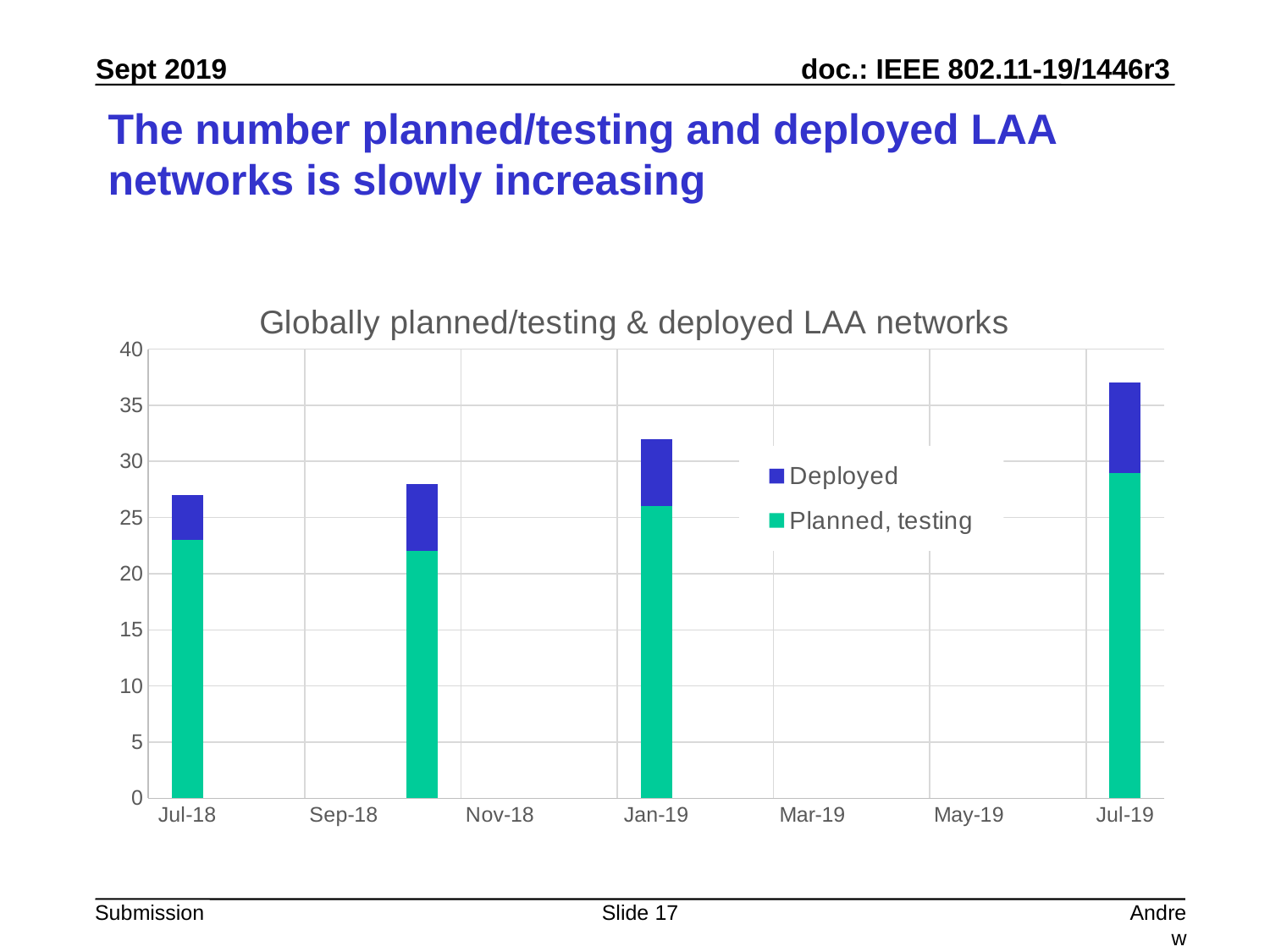
What kind of chart is shown on the slide? Stacked bar chart Which series is shown in green in the chart? Planned, testing Is the total value for Jan-19 greater or less than 30? greater Which has the larger total, Jan-19 or Jul-19? Jul-19 Do the total bar heights rise or fall from Jul-18 to Jul-19? Rise What is the title of the chart? Globally planned/testing & deployed LAA networks Which bar has the highest total in the chart? Jul-19 Is the 'Planned, testing' value for Jul-19 greater or less than 25? greater Is the total value for Jul-18 greater or less than 30? less How many bars are plotted in the chart? 4 How many series does the legend list? 2